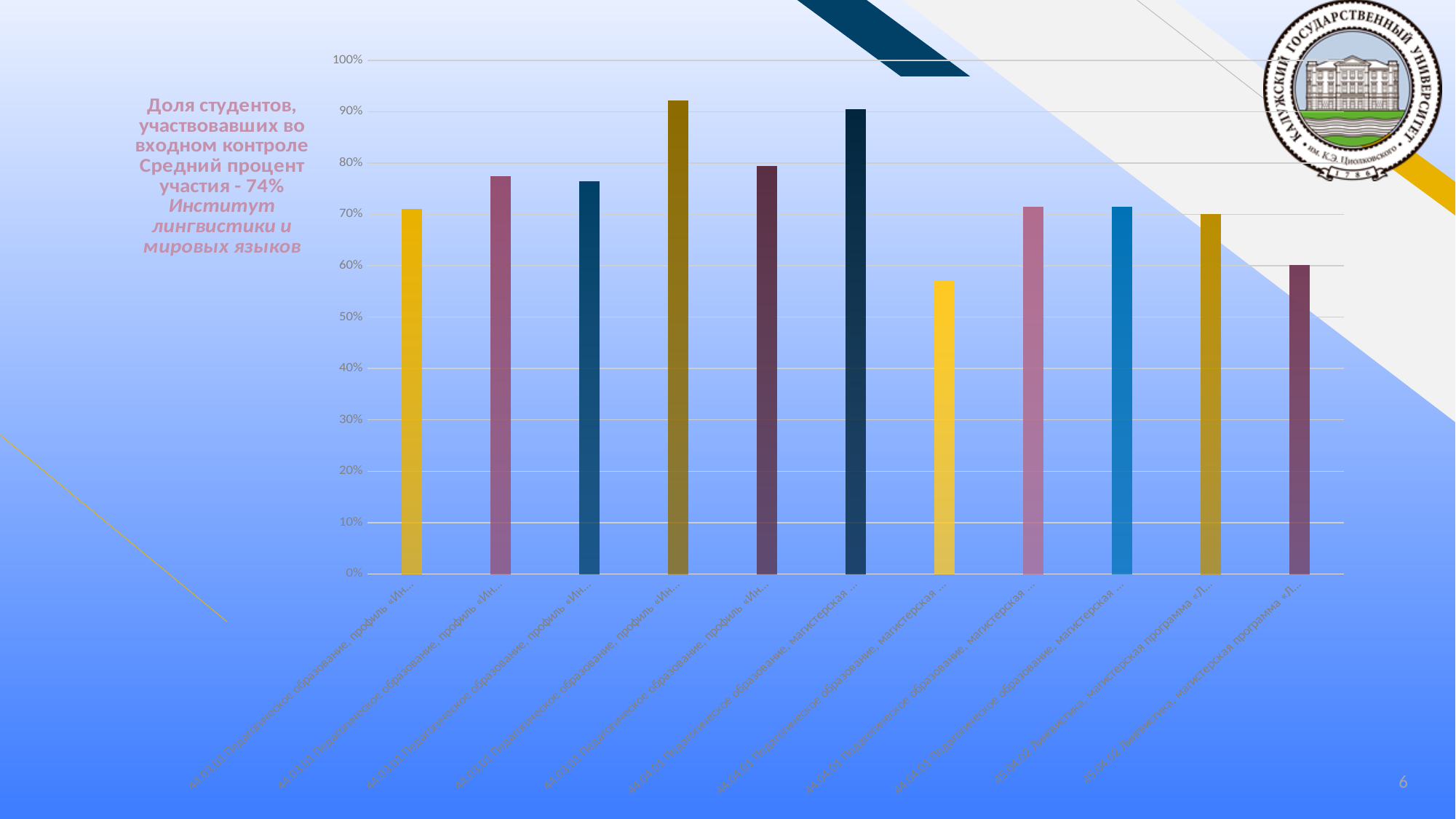
How many bars (categories) does the chart show? 11 What average participation percentage is stated in the text next to the chart? 74% Is the value of the 2nd bar from the left greater or less than 70%? greater Which bar is the tallest in the chart, counting from the left? the 4th bar Is the value of the 4th bar from the left greater or less than 80%? greater Is the value of the 7th bar from the left greater or less than 60%? less What kind of chart is shown on the slide? bar chart Which bar is the shortest in the chart, counting from the left? the 7th bar Which is larger: the 7th bar from the left or the 2nd bar from the left? the 2nd bar Which is larger: the 6th bar from the left or the 11th bar from the left? the 6th bar